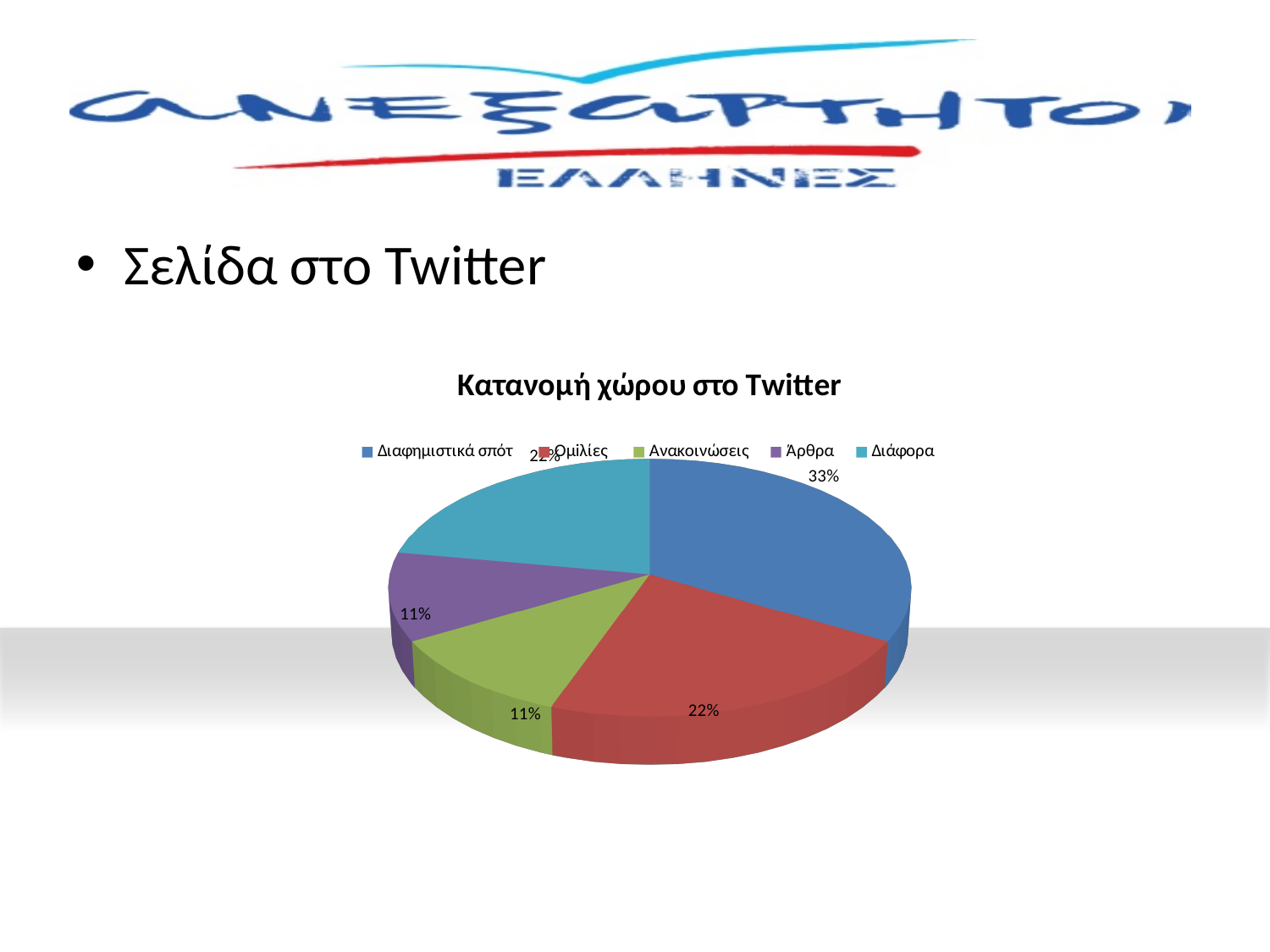
What share of the pie does Ανακοινώσεις have? 11% What is the title of the chart? Κατανομή χώρου στο Twitter What kind of chart is shown on the slide? pie chart Which category has the largest slice of the pie? Διαφημιστικά σποτ What share of the pie does Άρθρα have? 11% What share of the pie does Διαφημιστικά σποτ have? 33% What colour is the slice for Διάφορα? cyan What is the difference in percentage points between the Διαφημιστικά σποτ slice and the Ομιλίες slice? 11 Which is larger, the slice for Ομιλίες or the slice for Ανακοινώσεις? Ομιλίες How many categories does the legend of the pie chart list? 5 Is the share for Διαφημιστικά σποτ greater or less than 25%? greater